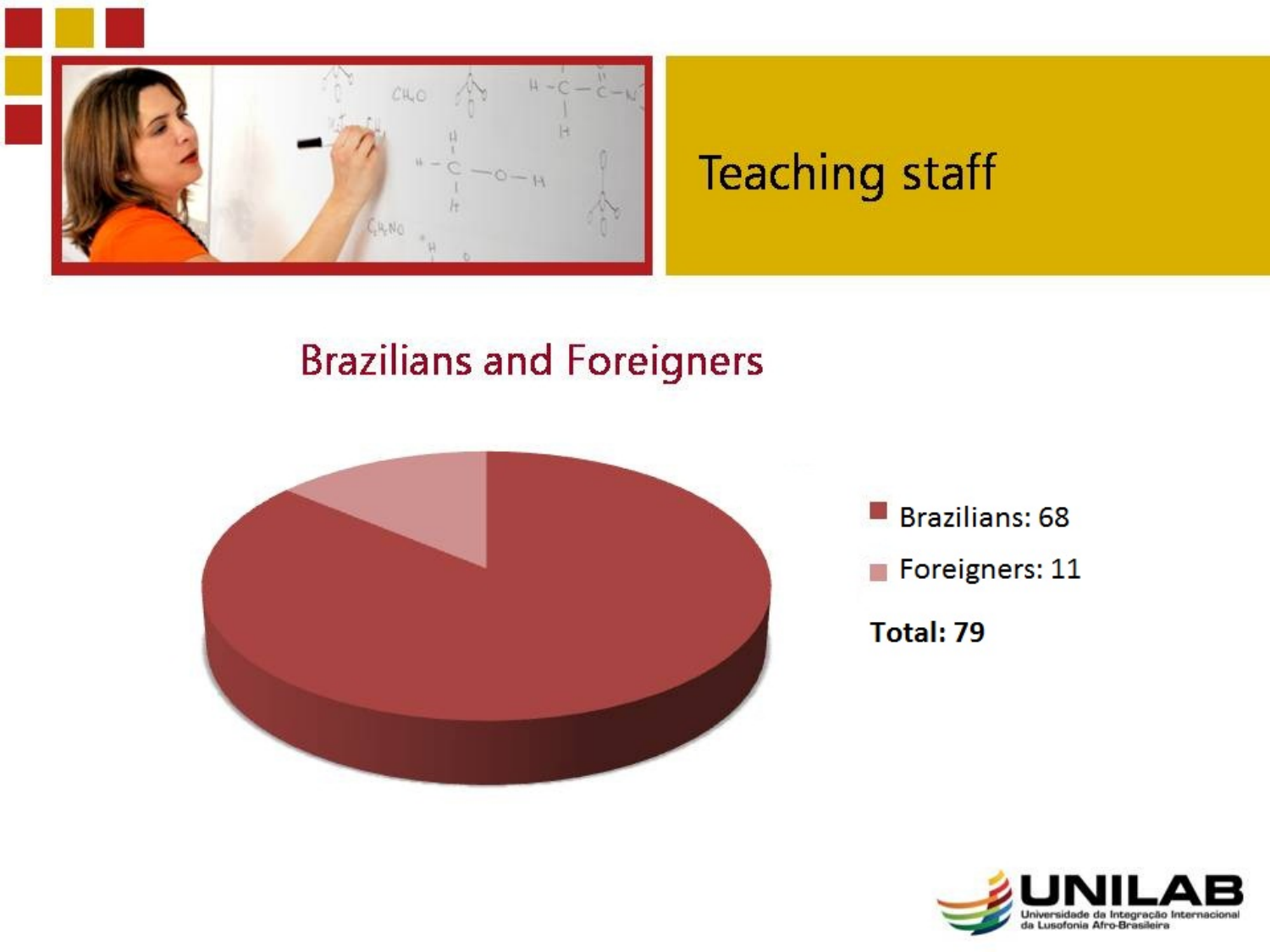
How many categories does the pie chart show? 2 What is the title of the chart? Brazilians and Foreigners Which category has the smallest slice of the pie chart? Foreigners Which category is shown in the lighter pink colour in the pie chart? Foreigners Which category has the largest slice of the pie chart? Brazilians What is the total of all slices in the pie chart? 79 What is the value for Brazilians in the pie chart? 68 What kind of chart is shown on the slide? Pie chart What is the value for Foreigners in the pie chart? 11 What is the difference between the number of Brazilians and the number of Foreigners? 57 Which is larger, the value for Brazilians or the value for Foreigners? Brazilians